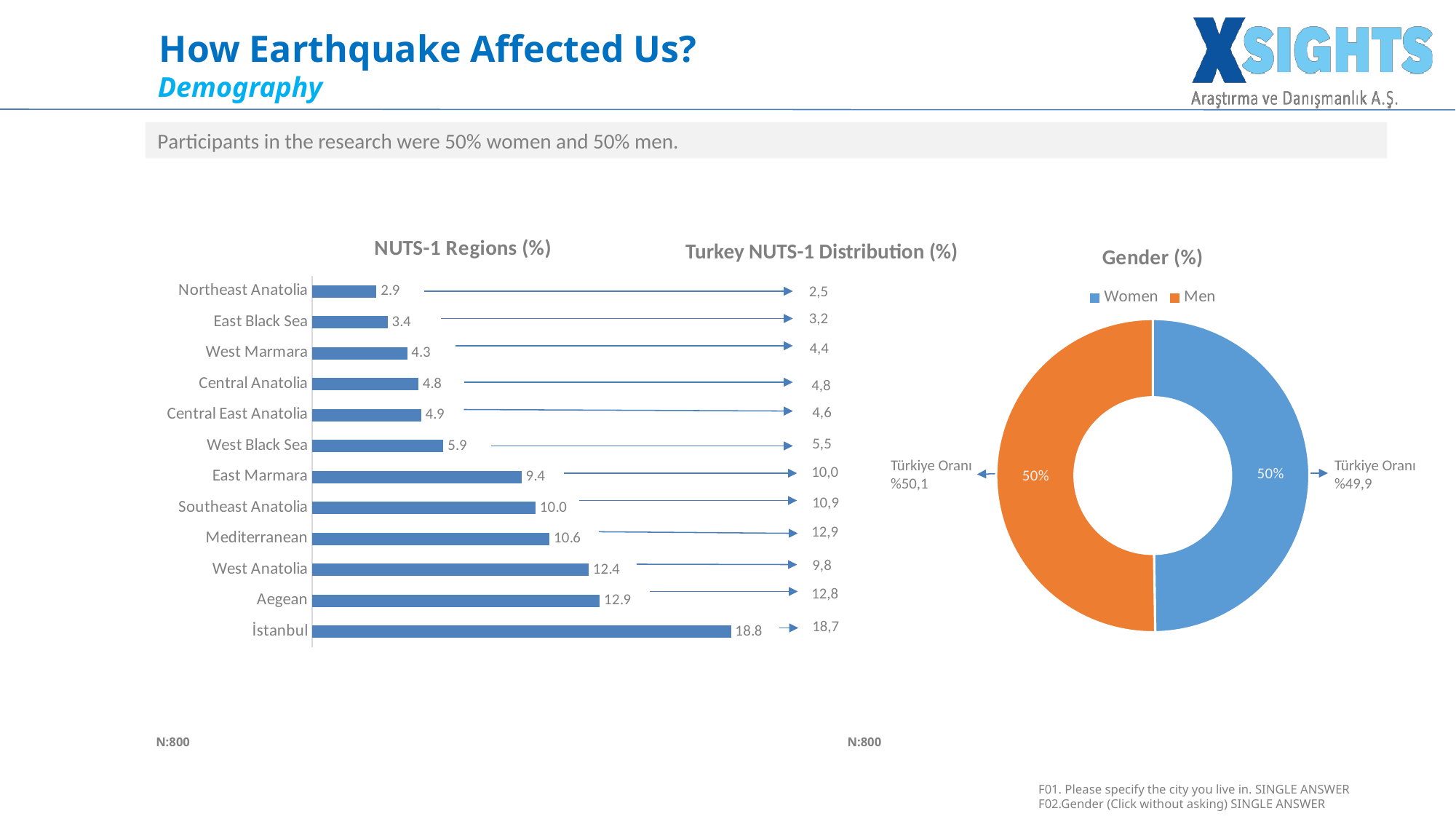
What kind of chart is the NUTS-1 Regions (%) chart? Bar chart What kind of chart is the Gender (%) chart? Doughnut chart In the NUTS-1 Regions (%) chart, what is the value for Mediterranean? 10.6 How many regions are shown in the NUTS-1 Regions (%) chart? 12 In the NUTS-1 Regions (%) chart, which region has the lowest value? Northeast Anatolia How many series does the legend of the Gender (%) chart list? 2 In the Gender (%) chart, what share is shown for Women? 50% In the NUTS-1 Regions (%) chart, what is the difference between the values for İstanbul and Aegean? 5.9 In the Gender (%) chart, which colour represents Men? Orange In the NUTS-1 Regions (%) chart, which region has the highest value? İstanbul In the NUTS-1 Regions (%) chart, which is larger, the value for West Anatolia or the value for East Marmara? West Anatolia In the NUTS-1 Regions (%) chart, what is the value for West Black Sea? 5.9